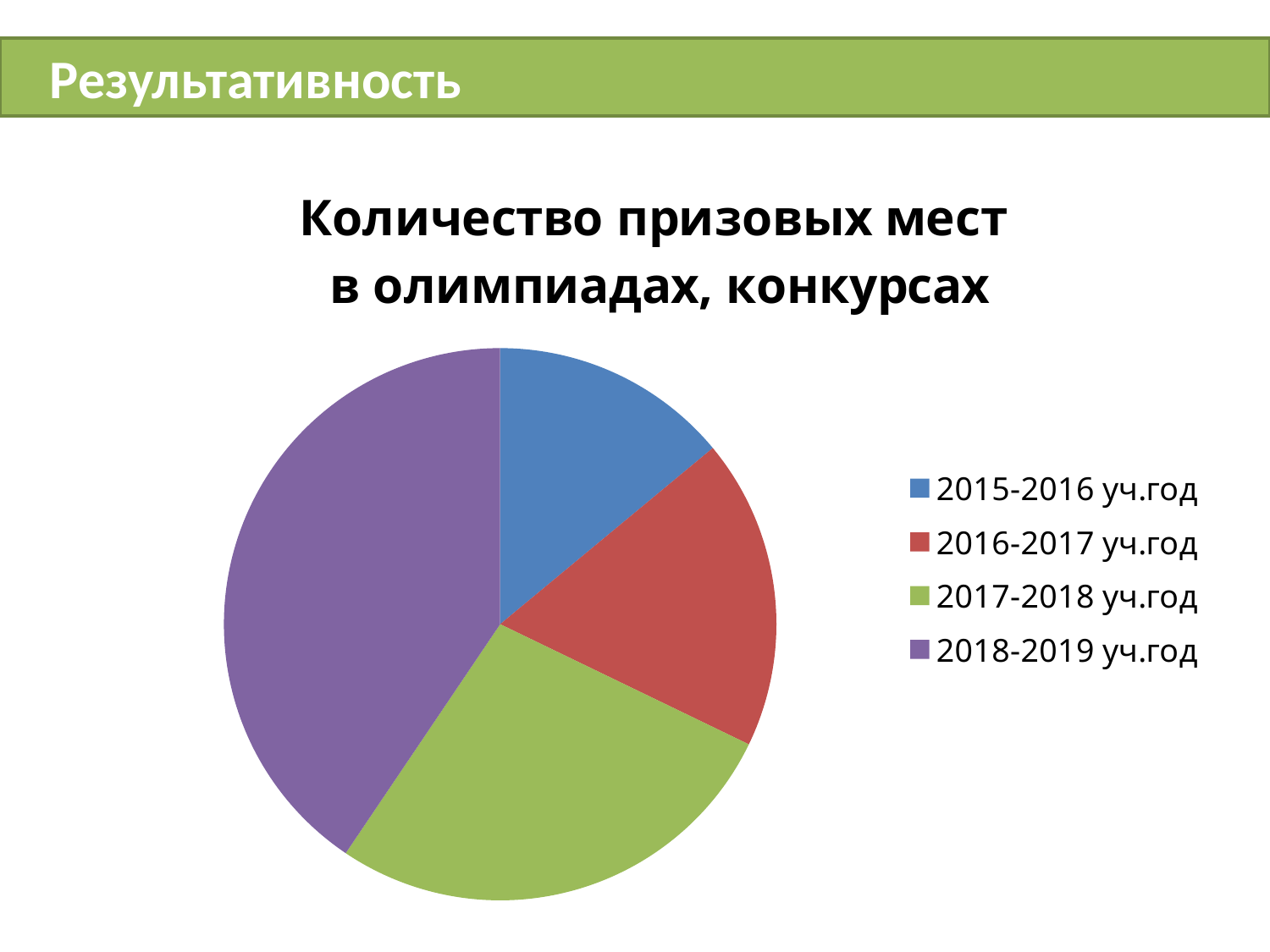
Which academic year is shown in purple in the pie chart? 2018-2019 уч.год Which slice is larger: 2018-2019 уч.год or 2017-2018 уч.год? 2018-2019 уч.год Which academic year has the largest slice of the pie chart? 2018-2019 уч.год Which slice is larger: 2017-2018 уч.год or 2015-2016 уч.год? 2017-2018 уч.год How many slices does the pie chart have? 4 How many entries does the legend of the pie chart list? 4 Which slice is larger: 2017-2018 уч.год or 2016-2017 уч.год? 2017-2018 уч.год What is the title of the pie chart? Количество призовых мест в олимпиадах, конкурсах Which academic year has the smallest slice of the pie chart? 2015-2016 уч.год What kind of chart is shown on the slide? pie chart